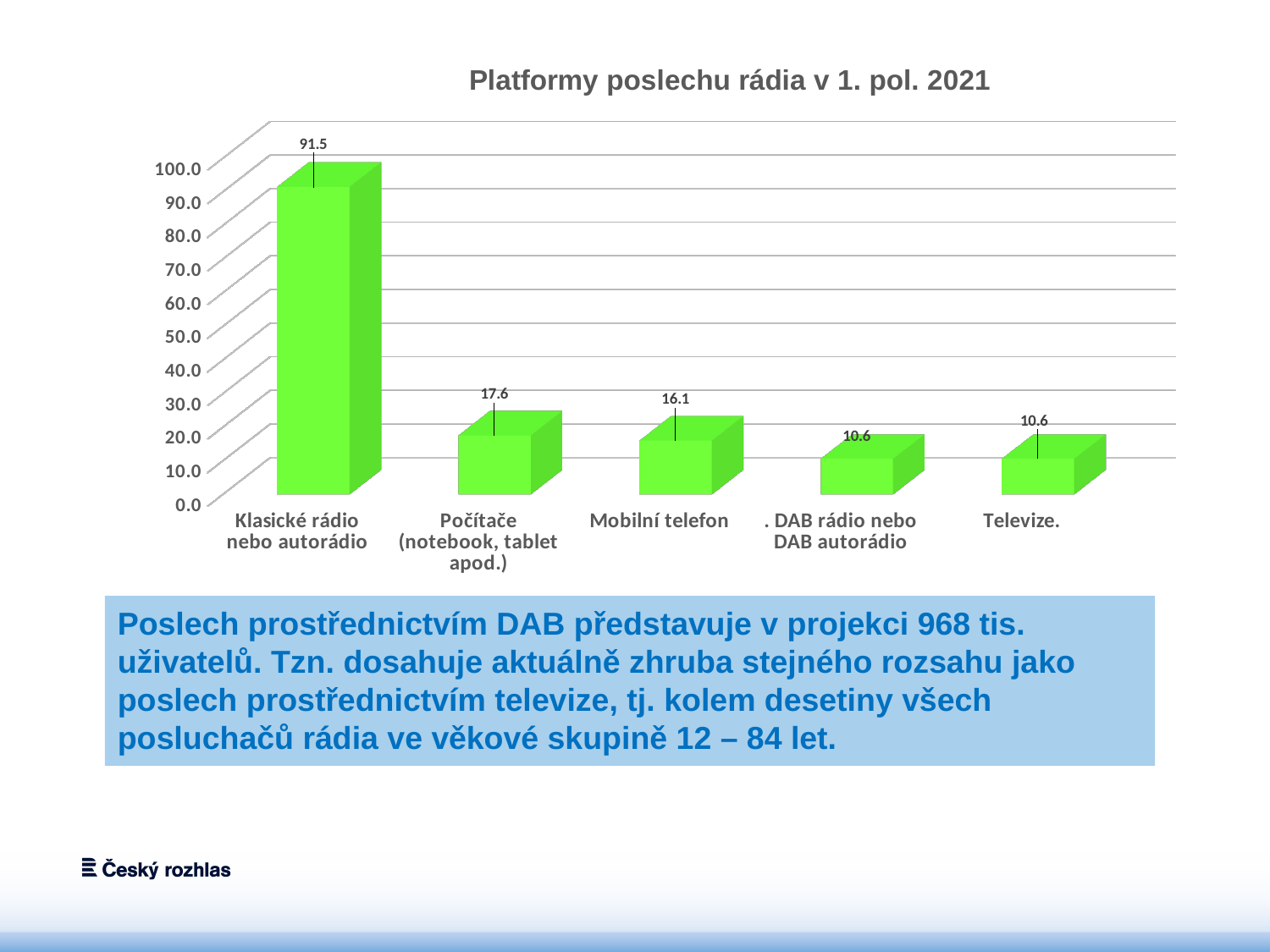
What kind of chart is shown on the slide? bar chart How many categories are shown in the chart? 5 What is the value for Mobilní telefon? 16.1 Which is larger, the value for Mobilní telefon or the value for Televize? Mobilní telefon What is the title of the chart? Platformy poslechu rádia v 1. pol. 2021 What is the value for Počítače (notebook, tablet apod.)? 17.6 What is the difference between the values for Klasické rádio nebo autorádio and Počítače (notebook, tablet apod.)? 73.9 Is the value for Klasické rádio nebo autorádio greater or less than 90.0? greater Which category has the highest value? Klasické rádio nebo autorádio What is the difference between the values for Počítače (notebook, tablet apod.) and Mobilní telefon? 1.5 What is the value for DAB rádio nebo DAB autorádio? 10.6 What is the value for Klasické rádio nebo autorádio? 91.5